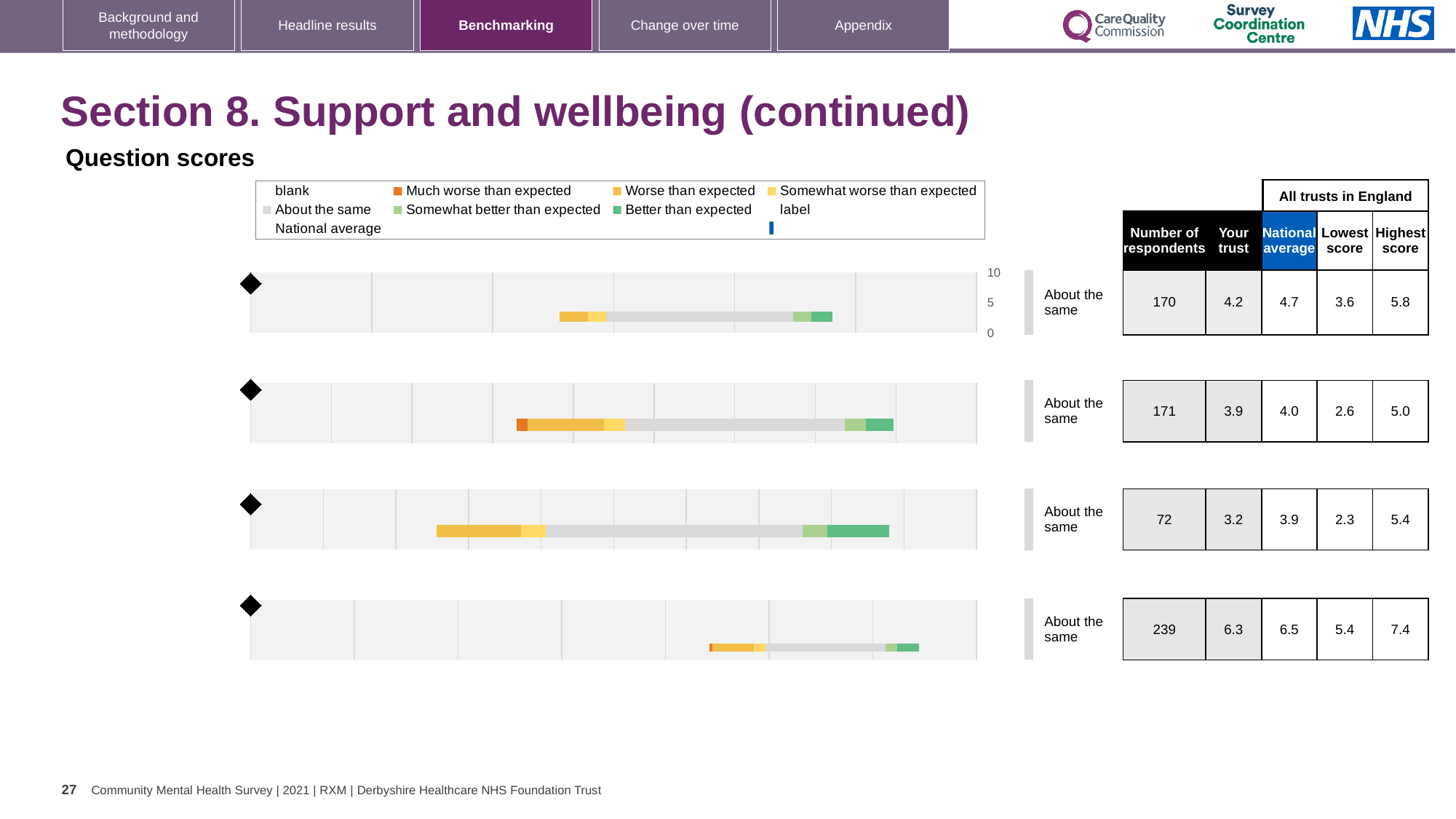
For the first (top) chart, what is the difference between the national average and the 'Your trust' score? 0.5 For the first (top) chart, what is the 'Your trust' score in the table? 4.2 How many benchmarking charts are shown on the slide? 4 What is the highest value shown on the vertical axis of the first (top) chart? 10 What colour does the legend use for 'Better than expected'? green Which chart row has the highest 'Your trust' score in the table? the fourth (bottom) chart, 6.3 What colour does the legend use for 'Much worse than expected'? orange What kind of chart is used for the four benchmarking charts on this slide? bar chart For the third chart, is the 'Your trust' score (3.2) larger or smaller than the national average (3.9)? smaller What benchmark category is shown next to the first (top) chart? About the same For the fourth (bottom) chart, what is the number of respondents in the table? 239 For the first (top) chart, what is the national average in the table? 4.7